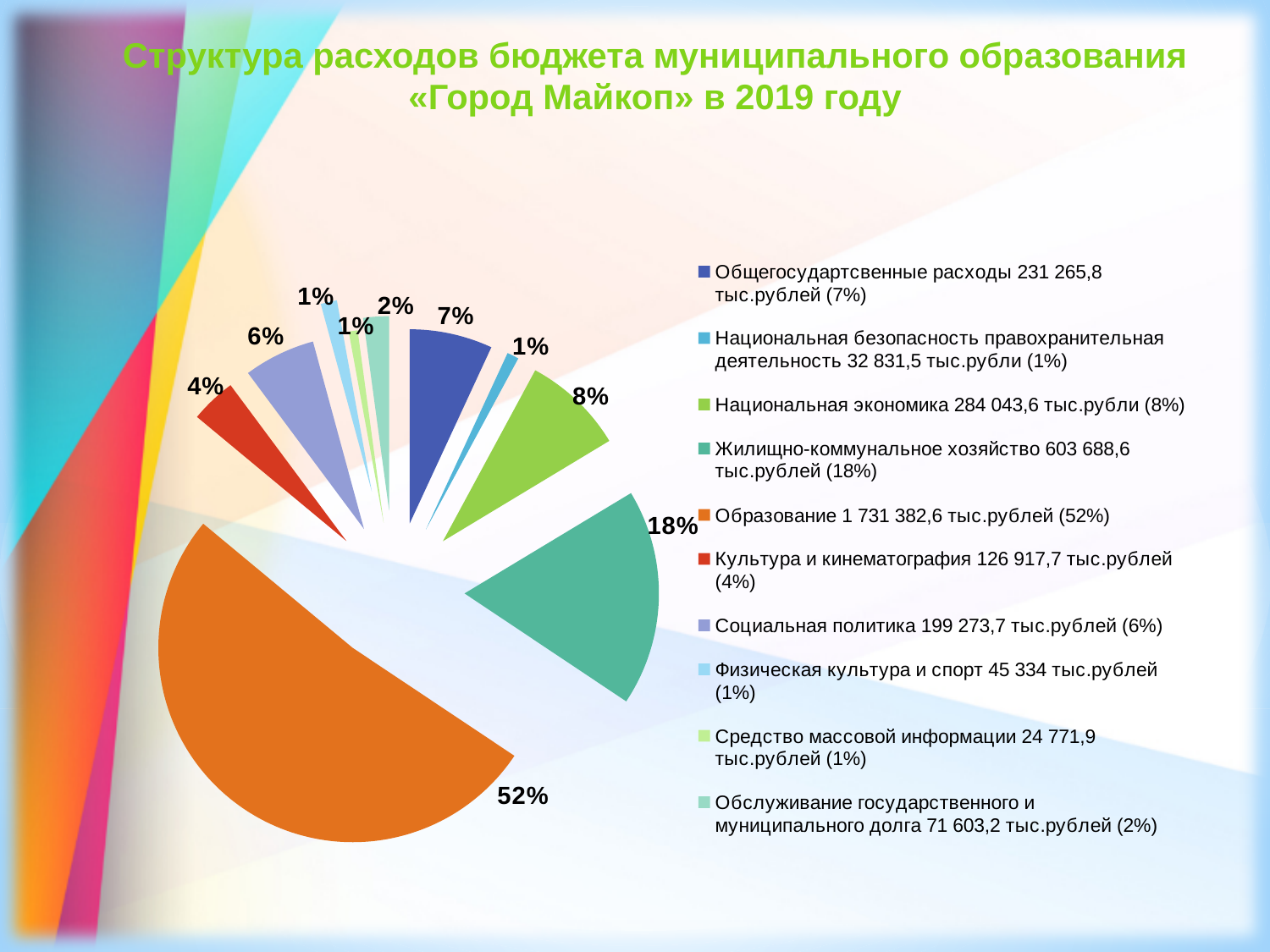
What is the amount for Национальная экономика according to the legend? 284 043,6 тыс.рубли What kind of chart is shown on the slide? pie chart What share of the pie does Жилищно-коммунальное хозяйство take? 18% Which is larger: the share for Социальная политика or the share for Культура и кинематография? Социальная политика What colour is the Образование slice in the pie chart? orange What share of the pie does Образование (education) take? 52% How many slices does the pie chart have? 10 What is the difference in percentage points between the Образование slice and the Жилищно-коммунальное хозяйство slice? 34 What share of the pie does Обслуживание государственного и муниципального долга take? 2% Which category has the largest slice of the pie? Образование What is the amount for Культура и кинематография according to the legend? 126 917,7 тыс.рублей What is the title of the chart on the slide? Структура расходов бюджета муниципального образования «Город Майкоп» в 2019 году